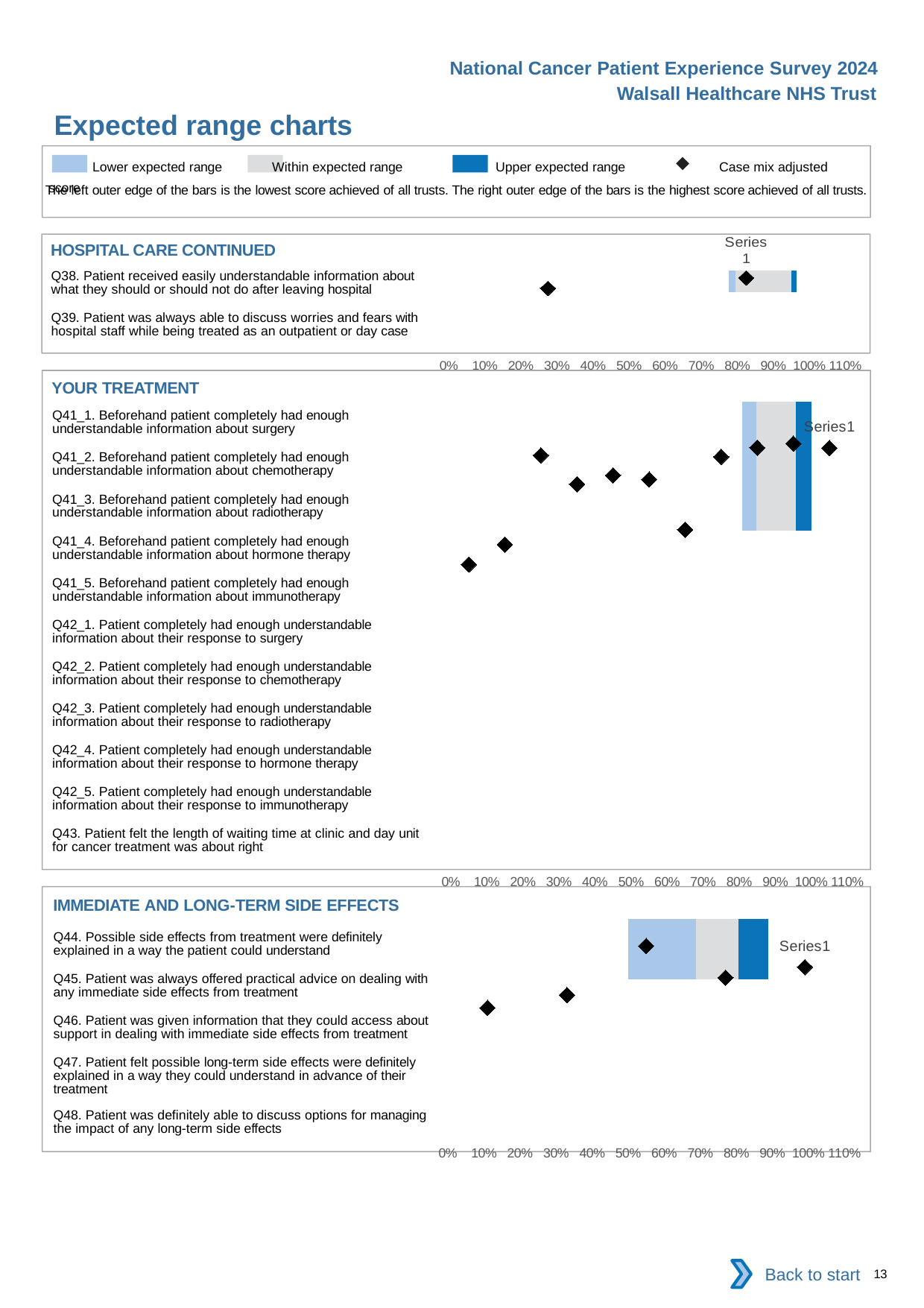
In the HOSPITAL CARE CONTINUED chart, is the leftmost diamond marker greater or less than 50%? less How many diamond markers are plotted in the YOUR TREATMENT chart? 11 How many diamond markers are plotted in the IMMEDIATE AND LONG-TERM SIDE EFFECTS chart? 5 How many questions (categories) are listed in the YOUR TREATMENT chart? 11 In the IMMEDIATE AND LONG-TERM SIDE EFFECTS chart, is the leftmost diamond marker greater or less than 20%? less What is the highest tick label shown on the x axis of the YOUR TREATMENT chart? 110% How many entries does the legend at the top of the slide list? 4 What is the title of the middle chart on the slide? YOUR TREATMENT In the YOUR TREATMENT chart, is the rightmost diamond marker greater or less than 90%? greater